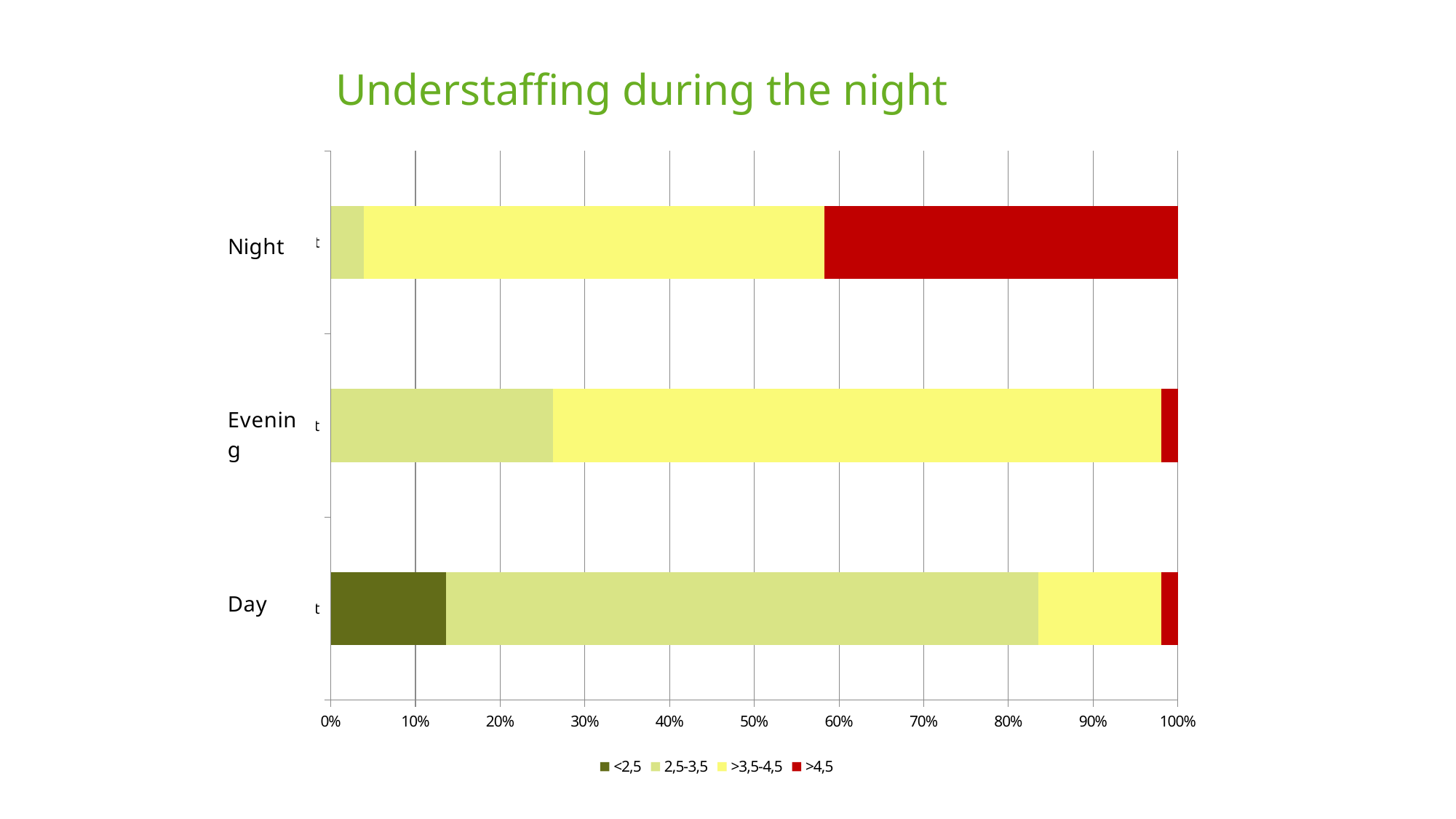
Which category has the largest >4,5 segment? Night Is the >4,5 segment larger for Night or for Evening? Night Which category has the largest >3,5-4,5 segment? Evening How many categories are plotted on the chart? 3 Which category has the largest 2,5-3,5 segment? Day Which category is the only one with a <2,5 segment? Day What is the total of the Night bar? 100% How many series does the legend list? 4 What kind of chart is shown on the slide? Stacked bar chart Is the >3,5-4,5 share for Night greater or less than 50%? greater What is the title of the chart? Understaffing during the night Is the <2,5 share for Day greater or less than 10%? greater